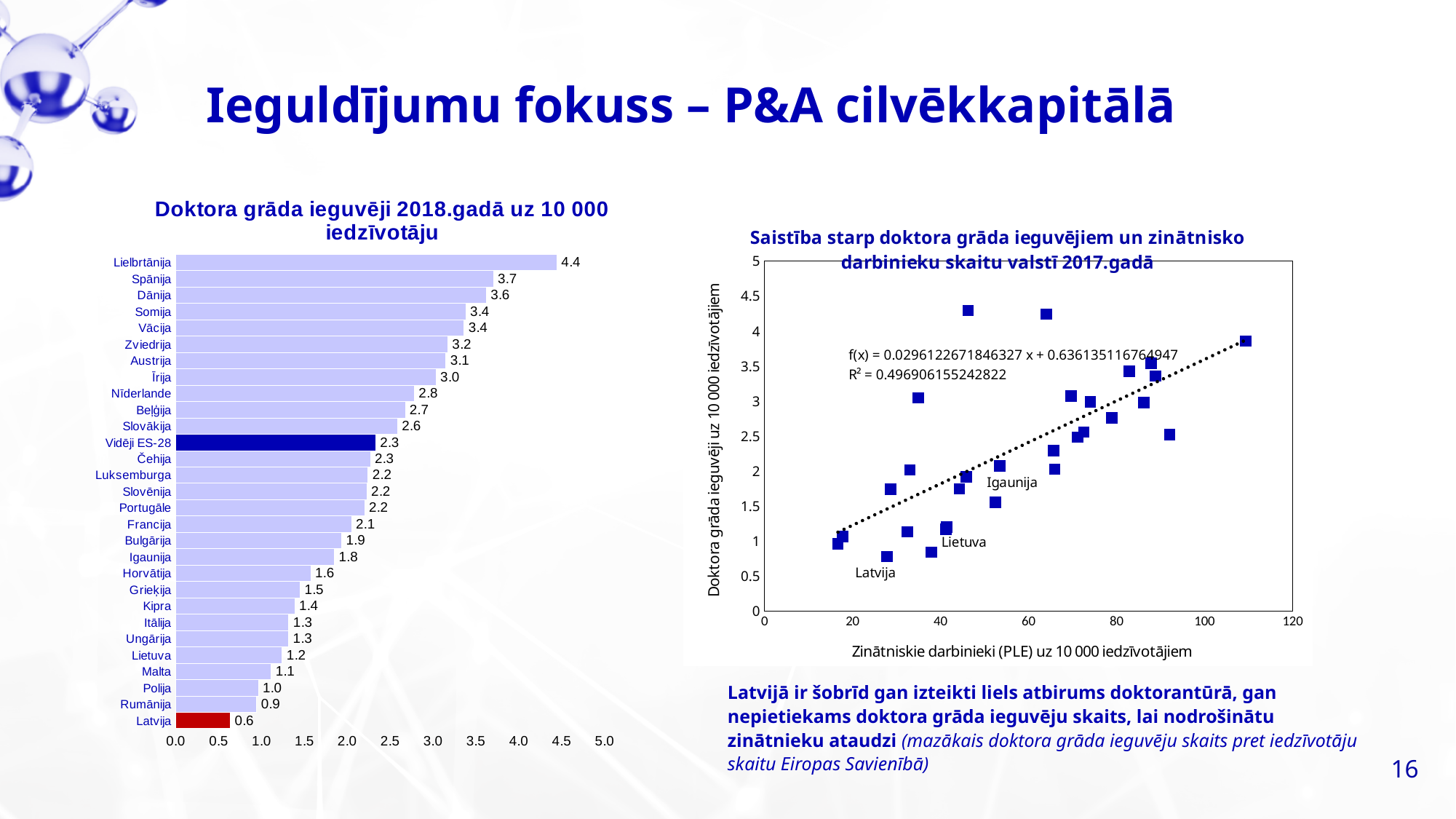
In the bar chart 'Doktora grāda ieguvēji 2018.gadā uz 10 000 iedzīvotāju', what is the difference between the values for Igaunija and Latvija? 1.2 In the bar chart 'Doktora grāda ieguvēji 2018.gadā uz 10 000 iedzīvotāju', which has a larger value, Lietuva or Polija? Lietuva What R² value is printed on the scatter plot on the right? 0.496906155242822 What kind of chart is the right chart 'Saistība starp doktora grāda ieguvējiem un zinātnisko darbinieku skaitu valstī 2017.gadā'? Scatter plot In the bar chart 'Doktora grāda ieguvēji 2018.gadā uz 10 000 iedzīvotāju', what is the value for Vidēji ES-28? 2.3 In the scatter plot on the right, does the fitted trend line rise or fall as the number of scientific workers increases? Rises How many categories (bars) are shown in the bar chart 'Doktora grāda ieguvēji 2018.gadā uz 10 000 iedzīvotāju'? 29 In the bar chart 'Doktora grāda ieguvēji 2018.gadā uz 10 000 iedzīvotāju', which country has the highest value? Lielbritānija In the bar chart 'Doktora grāda ieguvēji 2018.gadā uz 10 000 iedzīvotāju', what is the value for Lielbritānija? 4.4 What kind of chart is the left chart 'Doktora grāda ieguvēji 2018.gadā uz 10 000 iedzīvotāju'? Bar chart In the bar chart 'Doktora grāda ieguvēji 2018.gadā uz 10 000 iedzīvotāju', which country has the lowest value? Latvija